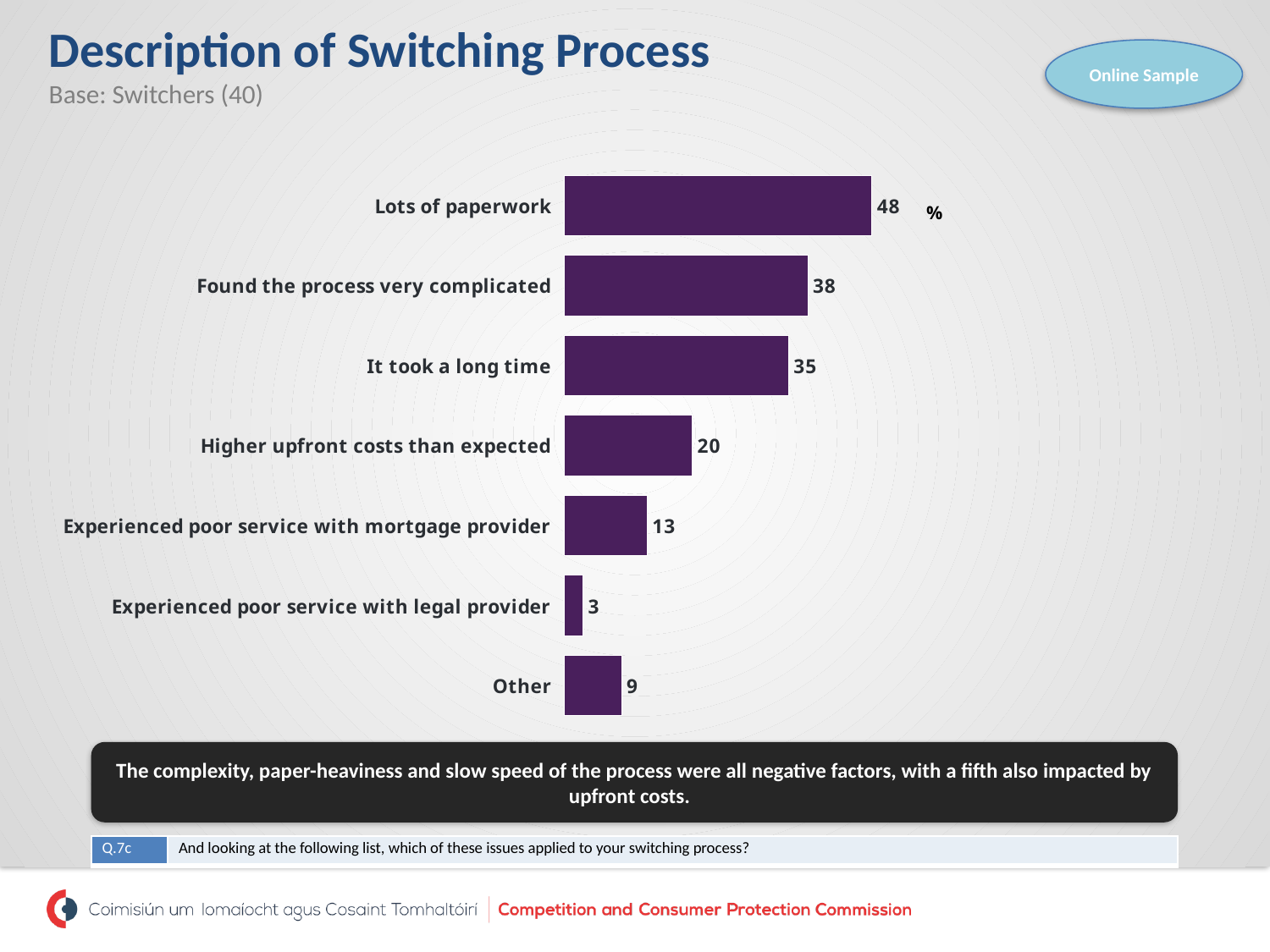
What is the value for "Lots of paperwork"? 48 Which is larger, the value for "Other" or the value for "Experienced poor service with legal provider"? Other What is the difference between the values for "It took a long time" and "Higher upfront costs than expected"? 15 What kind of chart is shown on the slide? Bar chart What is the value for "Found the process very complicated"? 38 Which category has the highest value? Lots of paperwork What is the value for "Other"? 9 What is the title of the slide containing the chart? Description of Switching Process What is the difference between the values for "Lots of paperwork" and "Found the process very complicated"? 10 What is the value for "Experienced poor service with mortgage provider"? 13 How many categories are shown in the chart? 7 Which category has the lowest value? Experienced poor service with legal provider